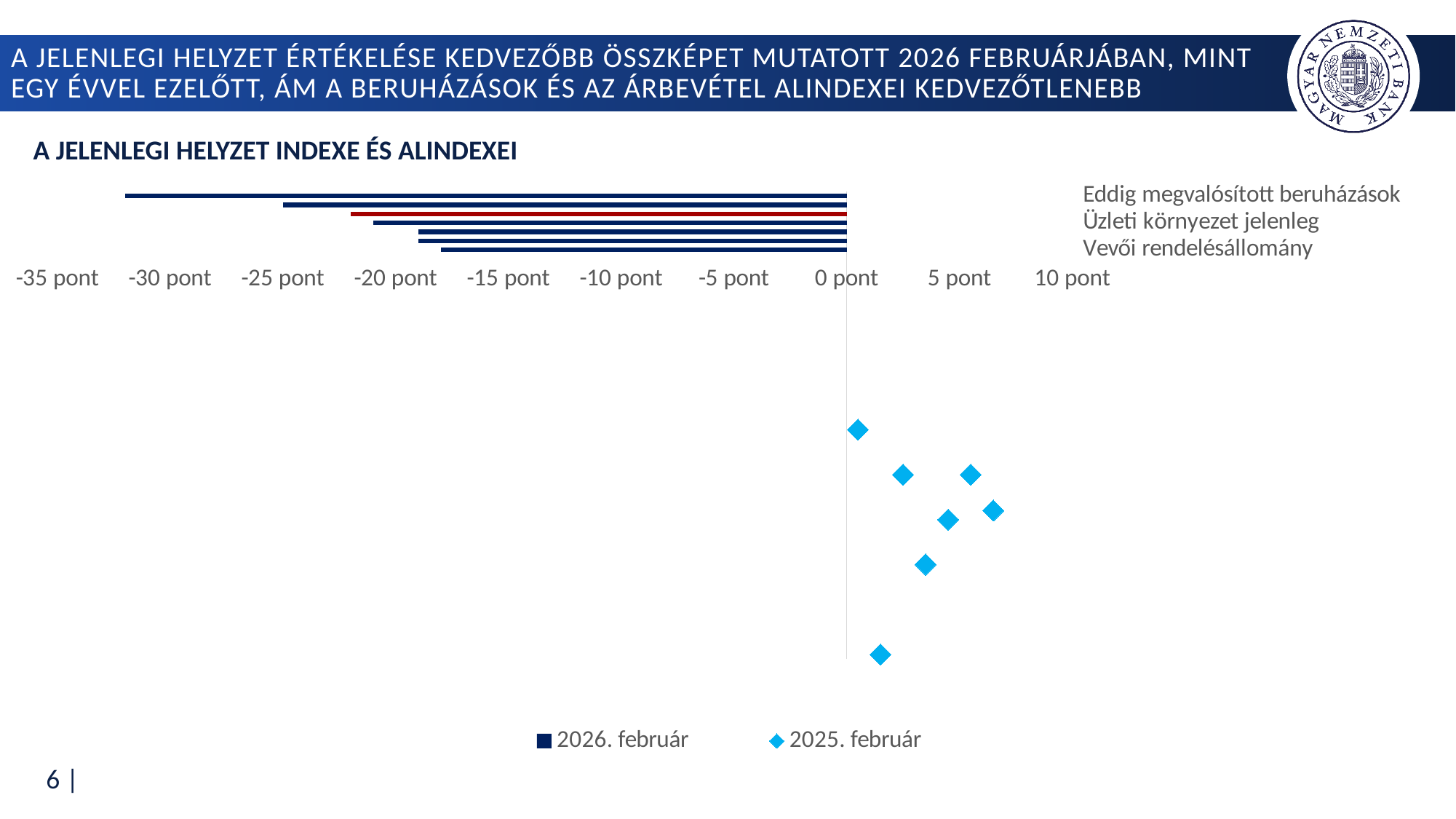
What is the title of the chart? A JELENLEGI HELYZET INDEXE ÉS ALINDEXEI What kind of chart is shown on the slide? bar chart What are the two series named in the legend? 2026. február and 2025. február How many horizontal bars are plotted for the 2026. február series? 7 Are the 2025. február marker values greater or less than 10 pont? less How many diamond markers are plotted for the 2025. február series? 7 Is the value of the longest 2026. február bar greater or less than -30 pont? less How many series does the legend list? 2 Are the 2026. február bar values greater or less than 0 pont? less